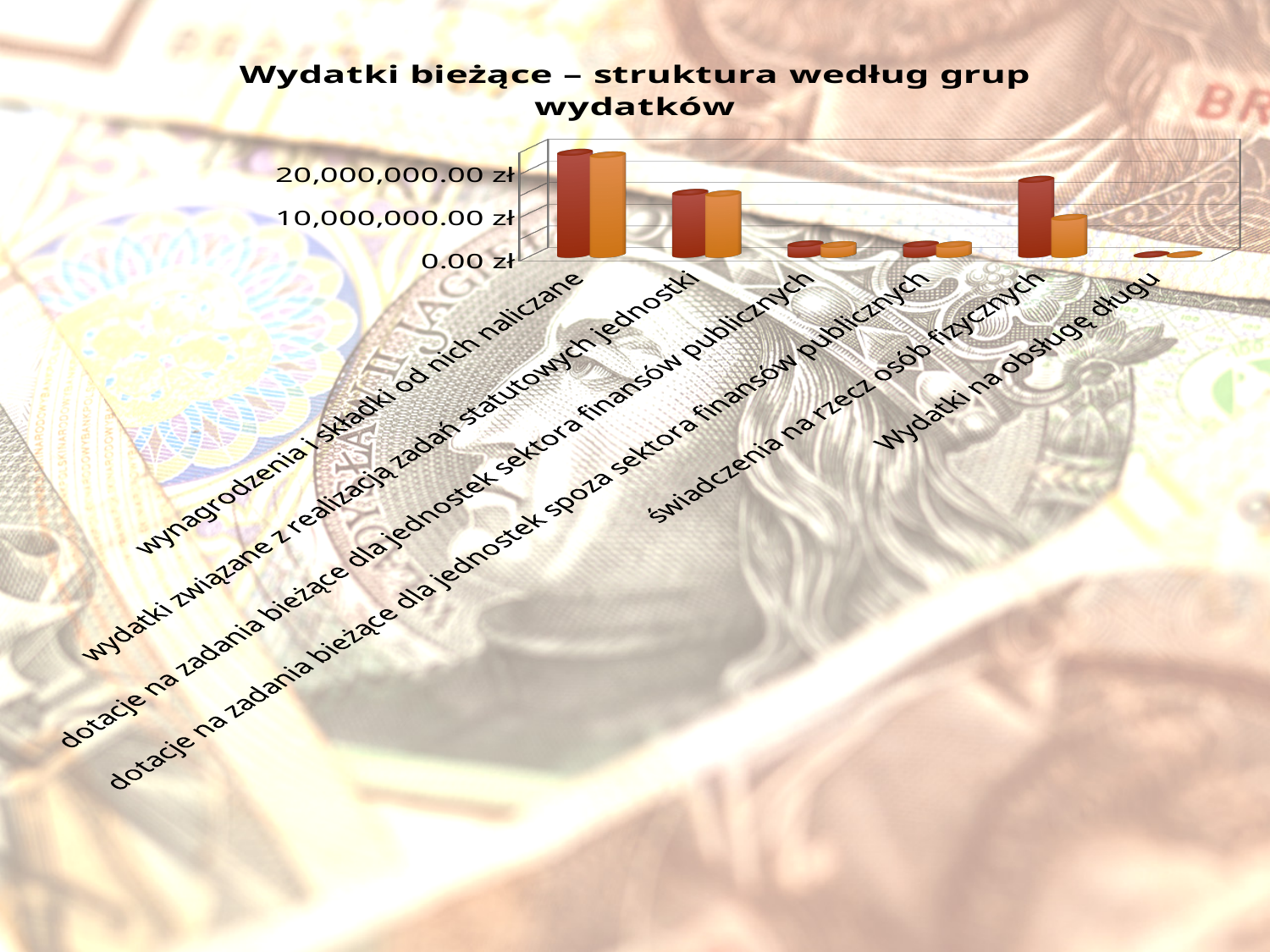
What kind of chart is shown on the slide? bar chart Which is larger: the value for wynagrodzenia i składki od nich naliczane or the value for świadczenia na rzecz osób fizycznych? wynagrodzenia i składki od nich naliczane Which is larger: the value for wydatki związane z realizacją zadań statutowych jednostki or the value for dotacje na zadania bieżące dla jednostek spoza sektora finansów publicznych? wydatki związane z realizacją zadań statutowych jednostki Is the value for Wydatki na obsługę długu greater or less than 10,000,000.00 zł? less Which category has the highest bars in the chart? wynagrodzenia i składki od nich naliczane Is the value for dotacje na zadania bieżące dla jednostek sektora finansów publicznych greater or less than 10,000,000.00 zł? less How many expenditure categories are shown on the x axis of the chart? 6 Which category has the lowest bars in the chart? Wydatki na obsługę długu Is the value for wynagrodzenia i składki od nich naliczane greater or less than 10,000,000.00 zł? greater How many bars are plotted for each category in the chart? 2 What is the title of the chart? Wydatki bieżące – struktura według grup wydatków What is the highest value labelled on the vertical axis of the chart? 20,000,000.00 zł